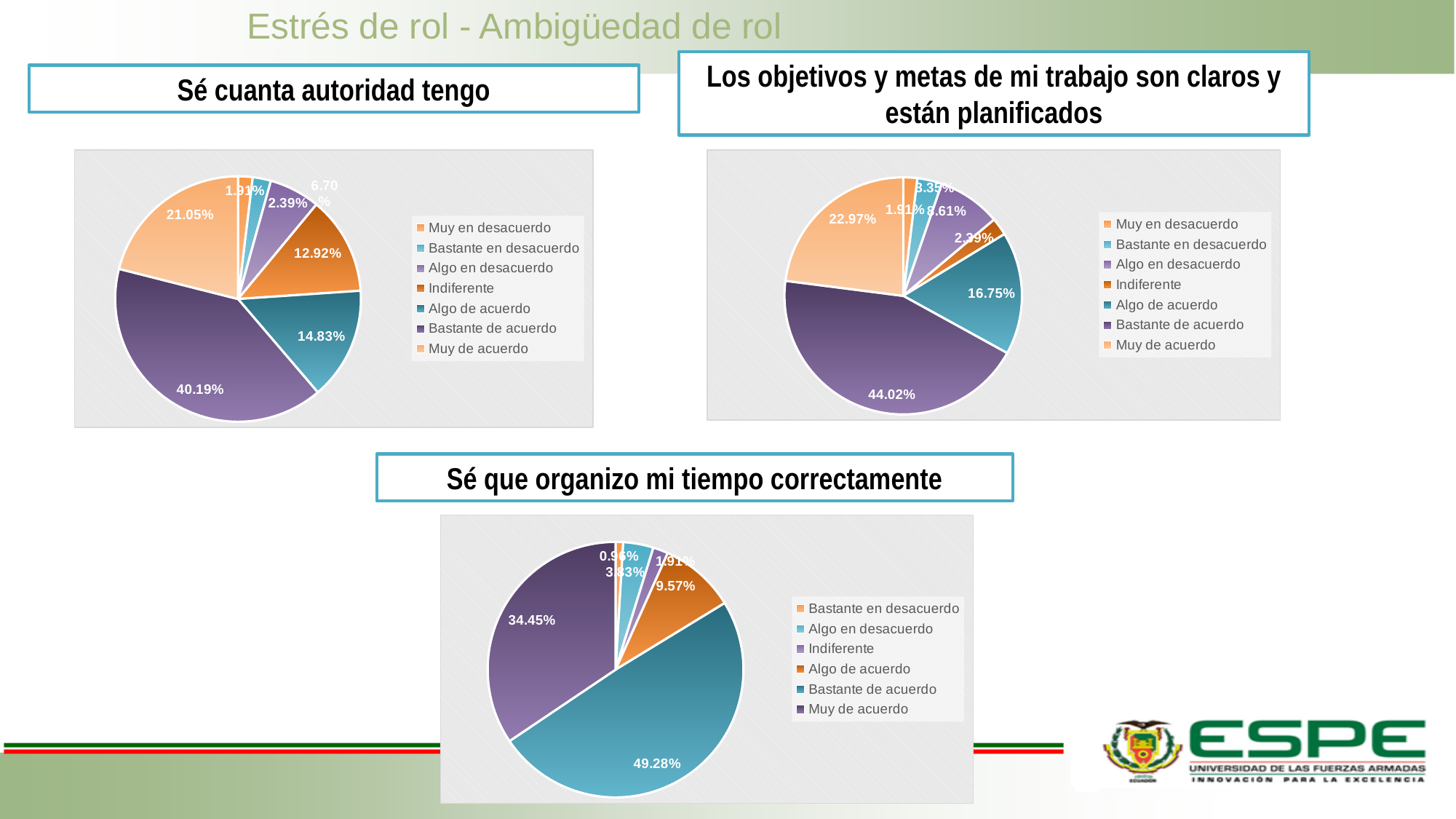
In the chart 'Los objetivos y metas de mi trabajo son claros y están planificados', which category has the smallest slice? Muy en desacuerdo In the chart 'Los objetivos y metas de mi trabajo son claros y están planificados', which is larger: 'Muy de acuerdo' or 'Algo de acuerdo'? Muy de acuerdo In the chart 'Sé que organizo mi tiempo correctamente', which category has the smallest slice? Bastante en desacuerdo In the chart 'Sé cuanta autoridad tengo', what percentage is shown for 'Bastante de acuerdo'? 40.19% In the chart 'Sé cuanta autoridad tengo', how many categories does the legend list? 7 In the chart 'Sé cuanta autoridad tengo', which category has the largest slice? Bastante de acuerdo In the chart 'Los objetivos y metas de mi trabajo son claros y están planificados', what is the difference between 'Bastante de acuerdo' and 'Muy de acuerdo'? 21.05% In the chart 'Sé que organizo mi tiempo correctamente', what percentage is shown for 'Bastante de acuerdo'? 49.28% In the chart 'Sé que organizo mi tiempo correctamente', how many categories does the legend list? 6 In the chart 'Sé cuanta autoridad tengo', what is the difference between the 'Muy de acuerdo' and 'Algo de acuerdo' slices? 6.22% What type of chart is used for 'Sé que organizo mi tiempo correctamente'? Pie chart In the chart 'Los objetivos y metas de mi trabajo son claros y están planificados', what percentage is shown for 'Algo de acuerdo'? 16.75%